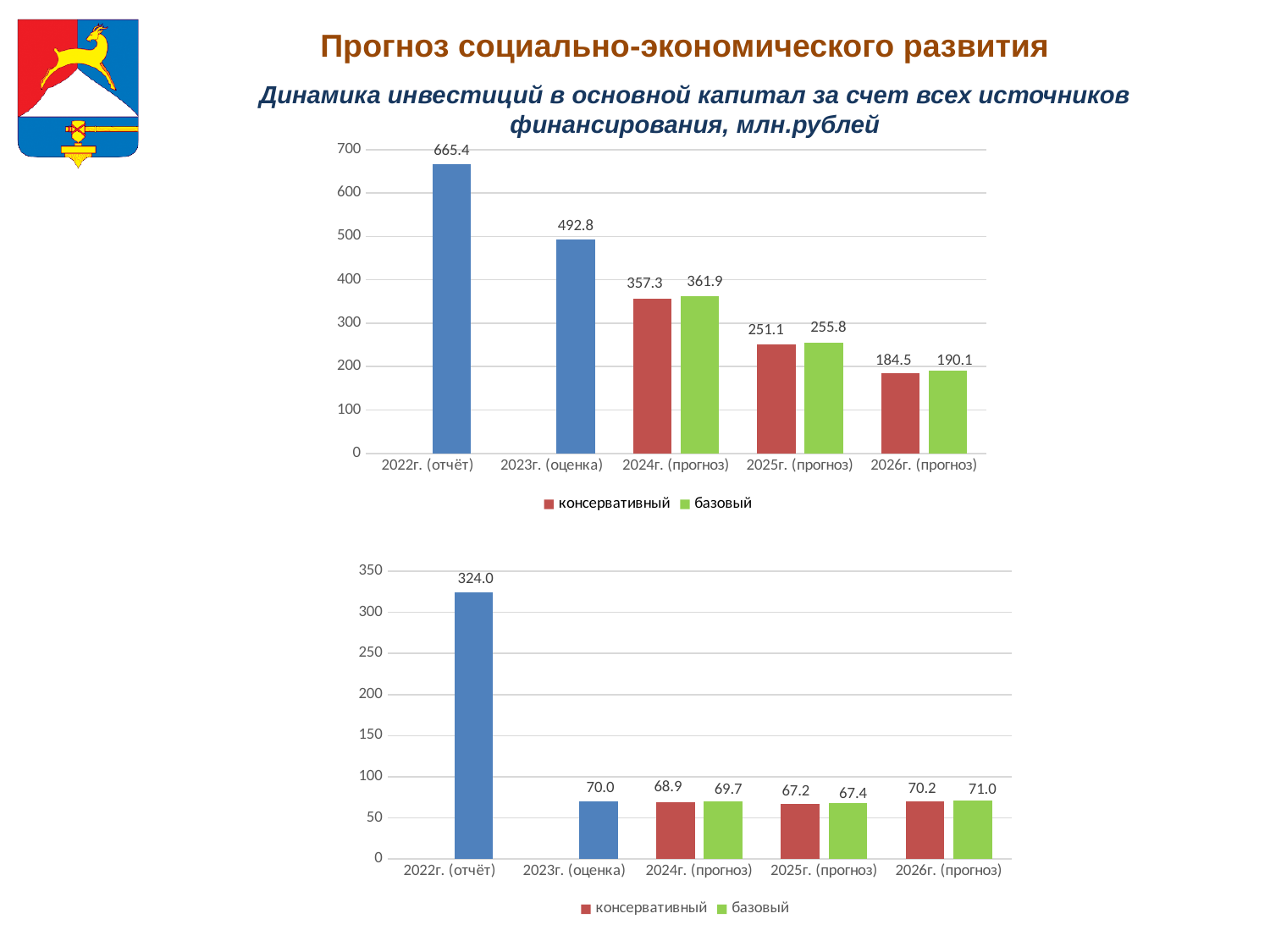
In the bottom chart, what is the консервативный value for 2025г. (прогноз)? 67.2 What kind of chart is the bottom chart? bar chart How many series does the legend of the top chart list? 2 In the bottom chart, what is the difference between the value for 2022г. (отчёт) and the value for 2023г. (оценка)? 254.0 In the top chart, do the values rise or fall from 2022г. (отчёт) to 2026г. (прогноз)? fall In the bottom chart, which is larger: the базовый value for 2026г. (прогноз) or the value for 2023г. (оценка)? базовый value for 2026г. (прогноз) In the top chart, what is the консервативный value for 2026г. (прогноз)? 184.5 In the top chart, which category has the highest value? 2022г. (отчёт) In the top chart, what is the базовый value for 2025г. (прогноз)? 255.8 In the top chart, what is the value for 2022г. (отчёт)? 665.4 In the top chart, what is the difference between the базовый and консервативный values for 2024г. (прогноз)? 4.6 In the bottom chart, what is the value for 2022г. (отчёт)? 324.0